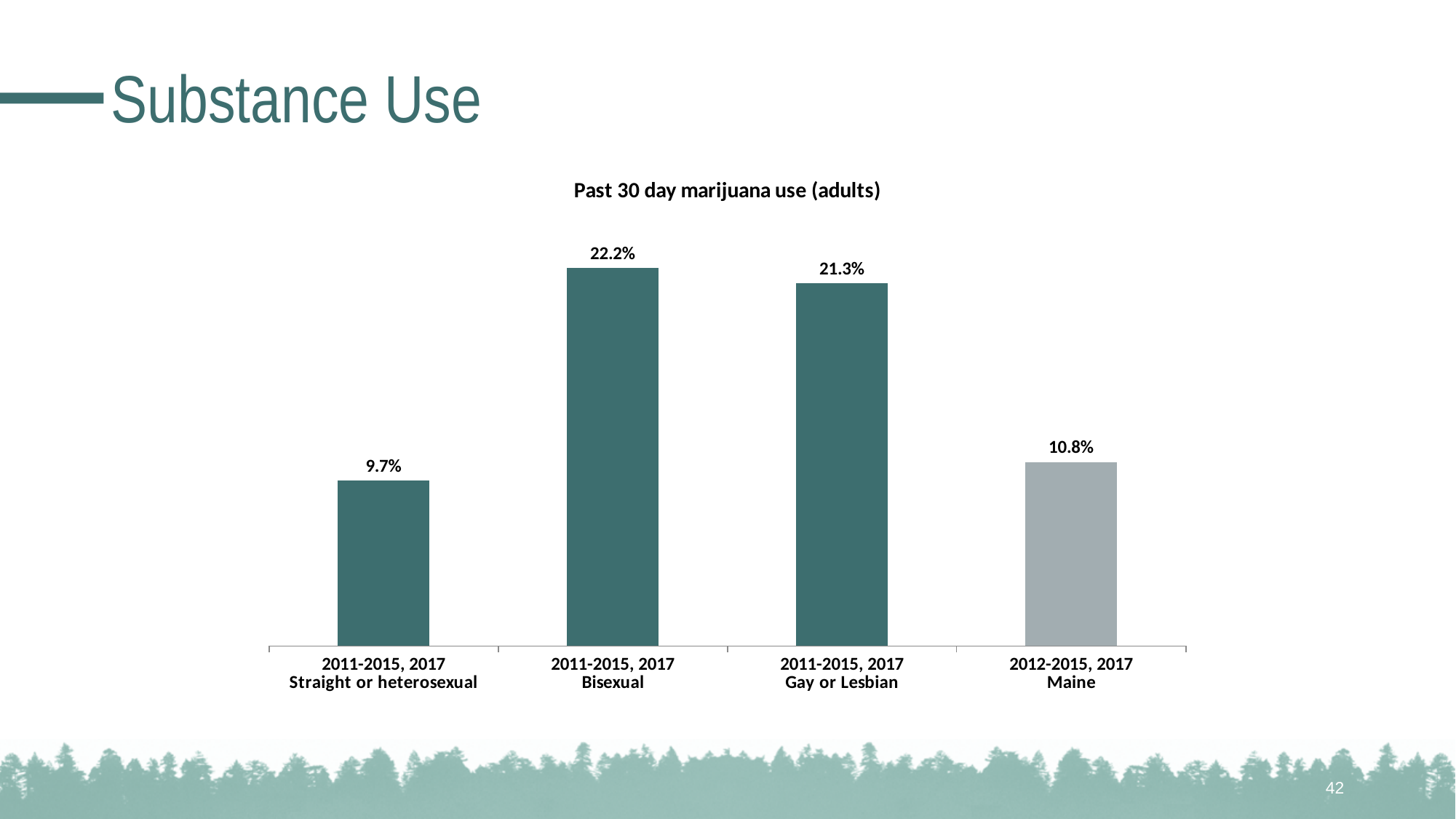
Which category has the highest past 30 day marijuana use? Bisexual What is the past 30 day marijuana use value for Bisexual adults? 22.2% What is the title of the chart? Past 30 day marijuana use (adults) Which category has the lowest past 30 day marijuana use? Straight or heterosexual What is the difference between the Maine value and the Straight or heterosexual value? 1.1% What is the past 30 day marijuana use value for Straight or heterosexual adults? 9.7% What kind of chart is shown on the slide? Bar chart What is the past 30 day marijuana use value for Gay or Lesbian adults? 21.3% How many categories are shown in the chart? 4 What is the difference between the Bisexual and Straight or heterosexual values? 12.5% What is the past 30 day marijuana use value for Maine? 10.8% Which is larger, the value for Gay or Lesbian or the value for Maine? Gay or Lesbian